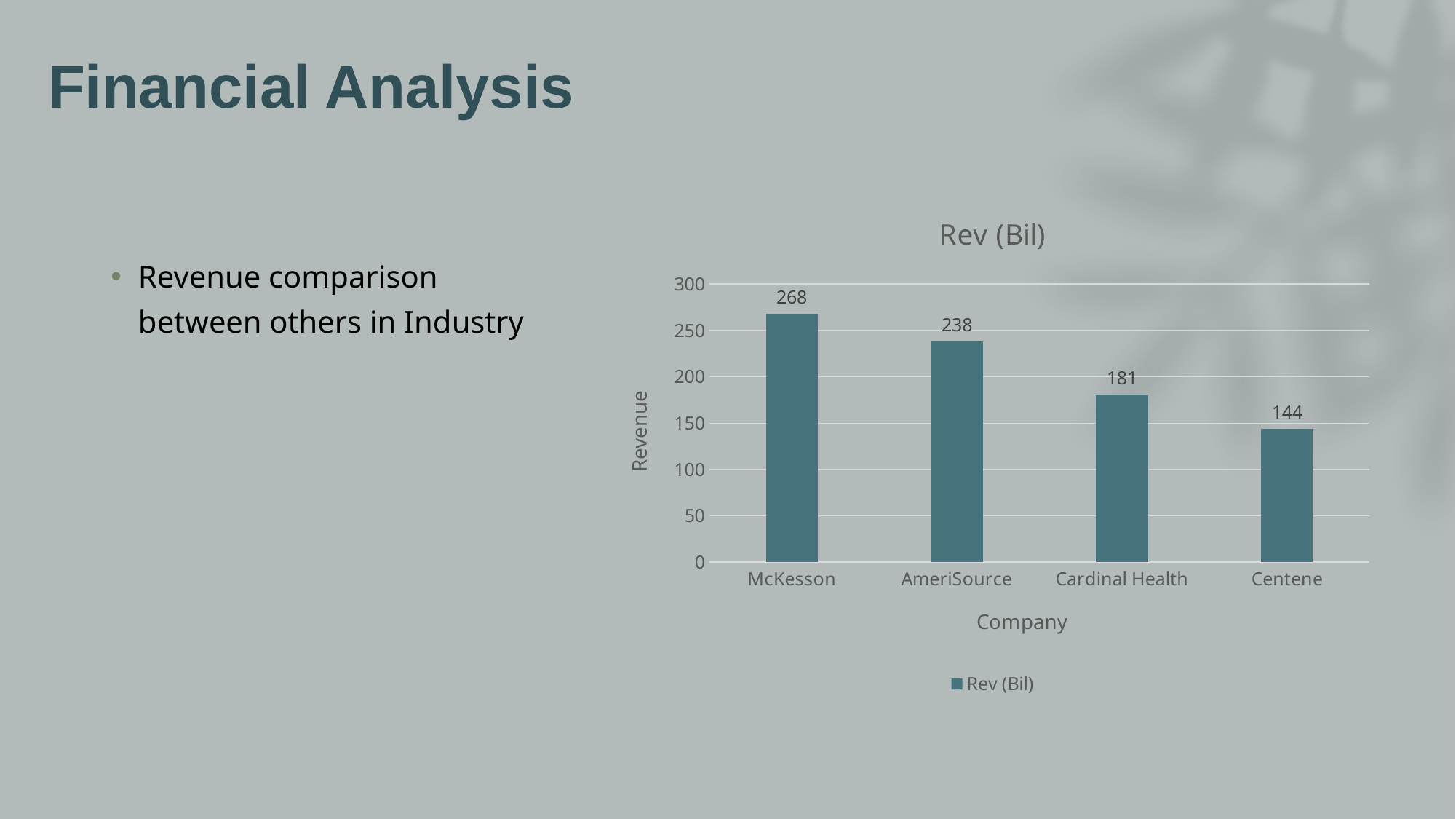
What is the difference between the revenue of McKesson and Centene? 124 How many companies are shown in the chart? 4 Which has a larger revenue value, AmeriSource or Cardinal Health? AmeriSource What is the revenue value shown for McKesson? 268 What is the revenue value shown for AmeriSource? 238 Which company has the highest revenue in the chart? McKesson How many series does the legend list? 1 What kind of chart is shown on the slide? Bar chart What is the revenue value shown for Centene? 144 What is the title of the chart? Rev (Bil) Which company has the lowest revenue in the chart? Centene What is the revenue value shown for Cardinal Health? 181